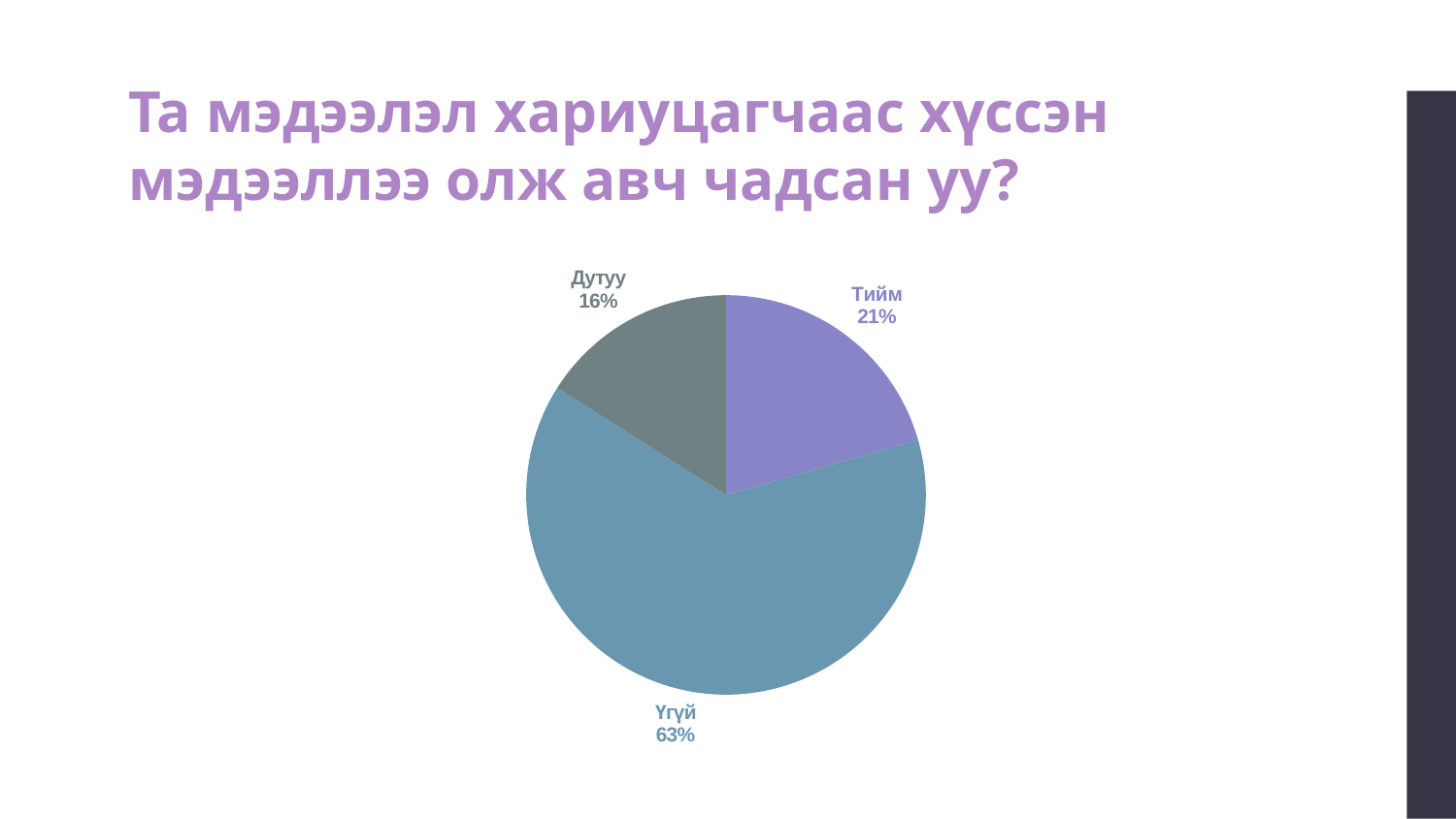
What kind of chart is shown on the slide? Pie chart What colour is the Үгүй slice? Blue-grey (teal) What is the value shown for the Дутуу slice? 16% What is the value shown for the Тийм slice? 21% Which slice of the pie is the largest? Үгүй What is the difference in percentage points between the Үгүй and Тийм slices? 42 What is the difference in percentage points between the Тийм and Дутуу slices? 5 Which slice of the pie is the smallest? Дутуу How many slices does the pie chart have? 3 What share of the pie does the Үгүй slice represent? 63% Which is larger, the Тийм slice or the Дутуу slice? Тийм What is the combined share of the Тийм and Дутуу slices? 37%